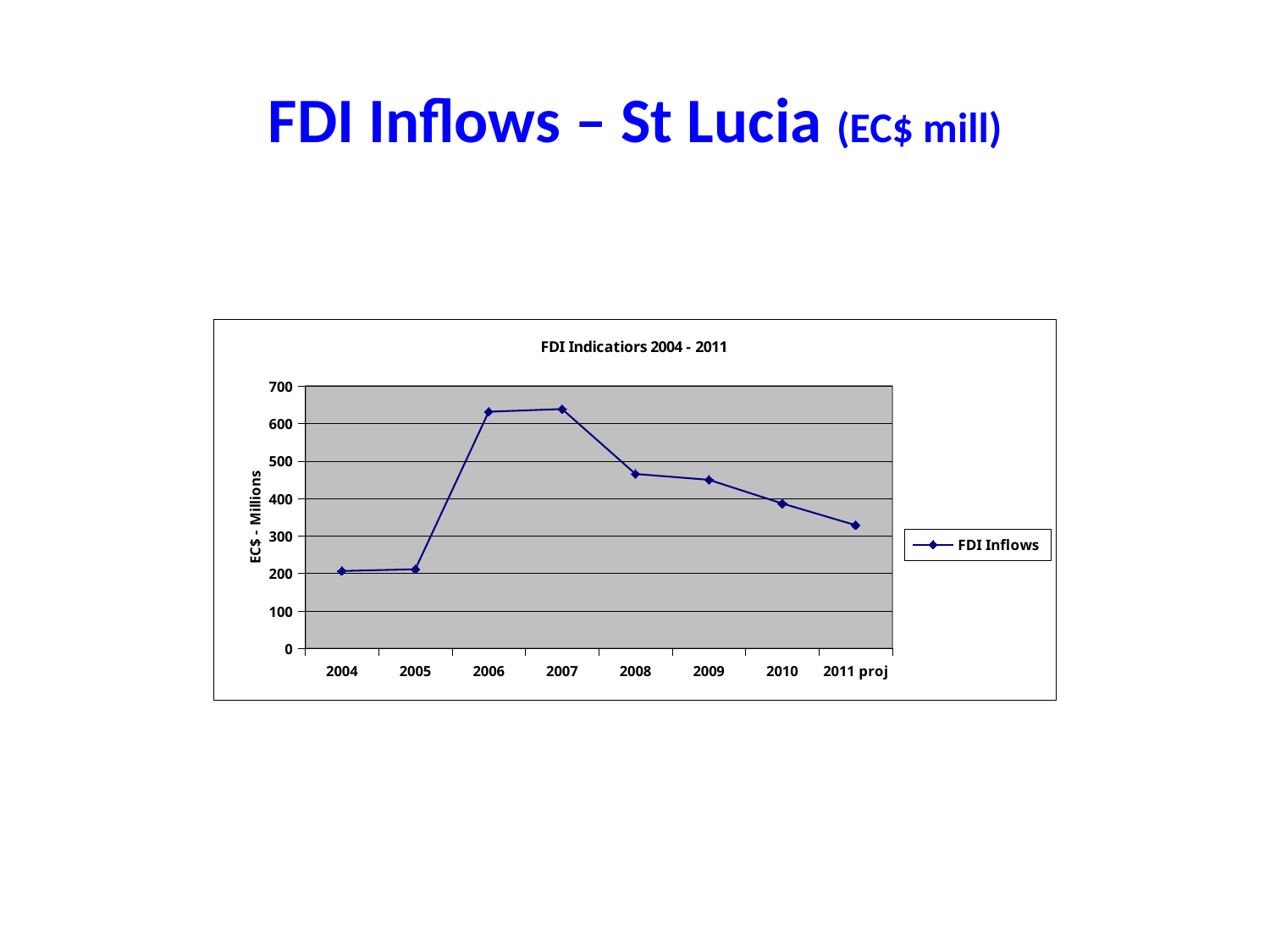
Is the value for 2010 greater or less than 400? less What is the label on the vertical axis of the chart? EC$ - Millions Is the value for 2011 proj greater or less than 300? greater How many data points are plotted on the FDI Inflows line? 8 Is the value for 2004 greater or less than 300? less Do the values rise or fall from 2007 to 2011 proj? fall Which year has the larger FDI inflow value, 2004 or 2006? 2006 How many series does the legend list? 1 What kind of chart is shown on the slide? line chart Which year has the larger FDI inflow value, 2008 or 2010? 2008